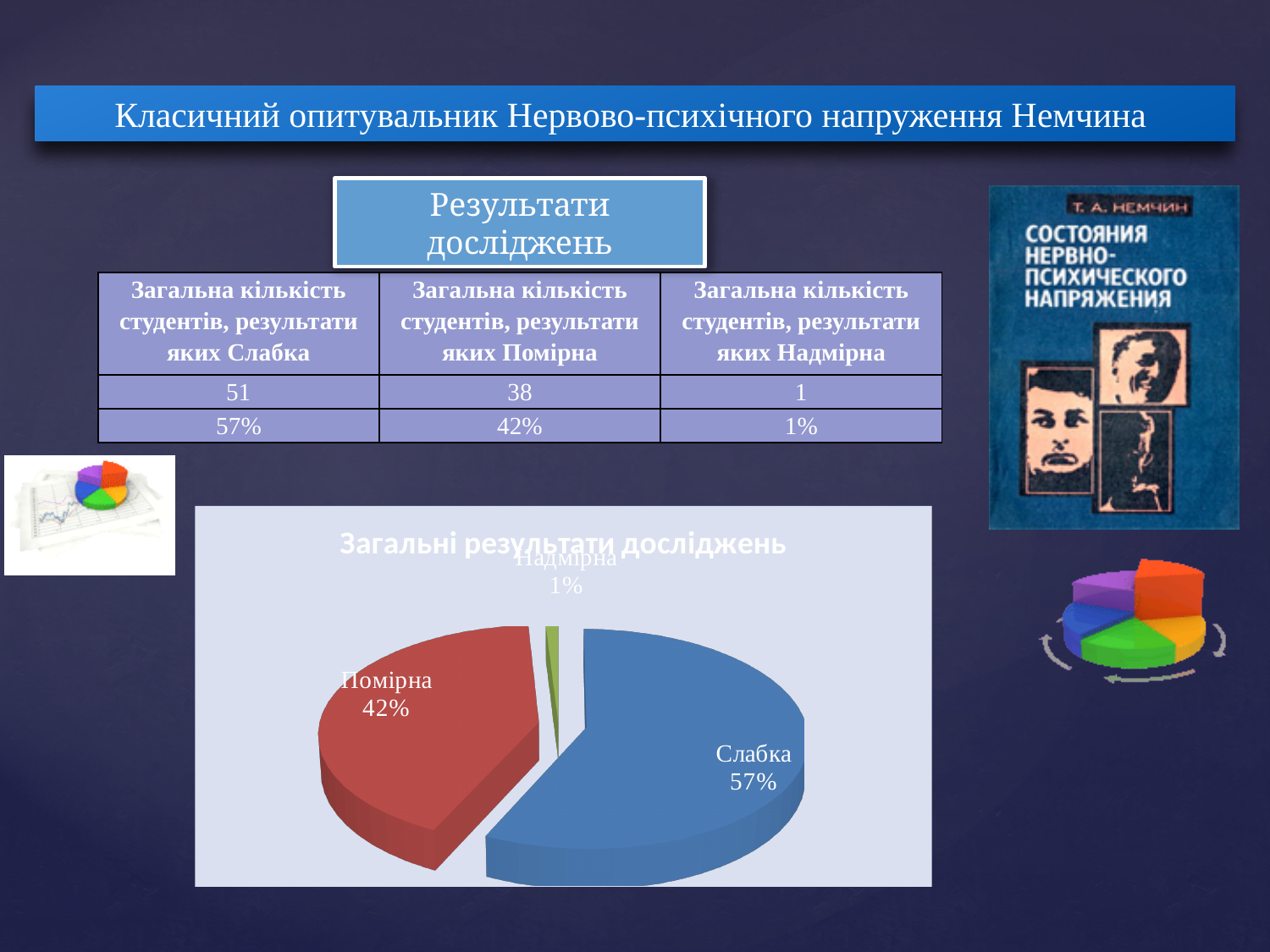
What share of the pie does the Помірна slice represent? 42% What kind of chart is shown on the slide? pie chart Which is larger, the Помірна slice or the Надмірна slice? Помірна What is the difference in percentage points between the Слабка and Помірна slices? 15% Which slice of the pie chart is the largest? Слабка What is the difference in percentage points between the Помірна and Надмірна slices? 41% What is the title of the pie chart? Загальні результати досліджень How many slices does the pie chart have? 3 Which slice of the pie chart is the smallest? Надмірна What colour is the Слабка slice in the pie chart? blue What share of the pie does the Надмірна slice represent? 1% What share of the pie does the Слабка slice represent? 57%